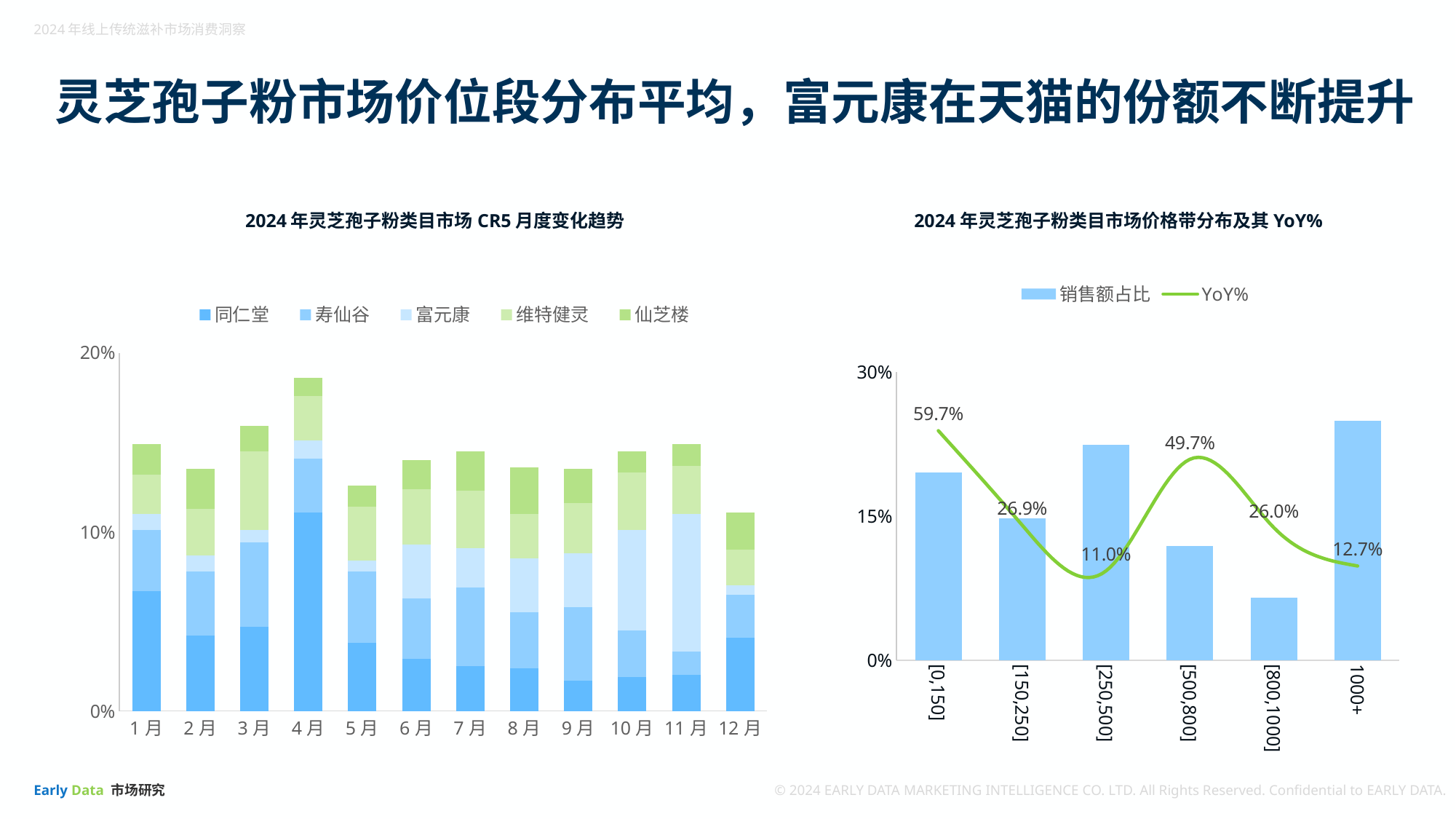
In the chart titled 2024 年灵芝孢子粉类目市场价格带分布及其 YoY%, what is the YoY% for the [0,150] price band? 59.7% In the chart titled 2024 年灵芝孢子粉类目市场价格带分布及其 YoY%, which price band has the lowest YoY%? [250,500] What kind of chart is the one titled 2024 年灵芝孢子粉类目市场 CR5 月度变化趋势? stacked bar chart In the chart titled 2024 年灵芝孢子粉类目市场价格带分布及其 YoY%, which price band has the highest YoY%? [0,150] In the chart titled 2024 年灵芝孢子粉类目市场价格带分布及其 YoY%, what is the YoY% for the [500,800] price band? 49.7% In the chart titled 2024 年灵芝孢子粉类目市场价格带分布及其 YoY%, how many price bands are shown on the x axis? 6 In the chart titled 2024 年灵芝孢子粉类目市场价格带分布及其 YoY%, is the 销售额占比 for 1000+ greater or less than 15%? greater In the chart titled 2024 年灵芝孢子粉类目市场价格带分布及其 YoY%, how many series does the legend list? 2 In the chart titled 2024 年灵芝孢子粉类目市场 CR5 月度变化趋势, which month has the highest total stacked bar? 4 月 In the chart titled 2024 年灵芝孢子粉类目市场价格带分布及其 YoY%, which has the larger YoY%, [150,250] or [800,1000]? [150,250] In the chart titled 2024 年灵芝孢子粉类目市场 CR5 月度变化趋势, how many brands does the legend list? 5 In the chart titled 2024 年灵芝孢子粉类目市场价格带分布及其 YoY%, what is the difference between the YoY% of [0,150] and the YoY% of [250,500]? 48.7 percentage points